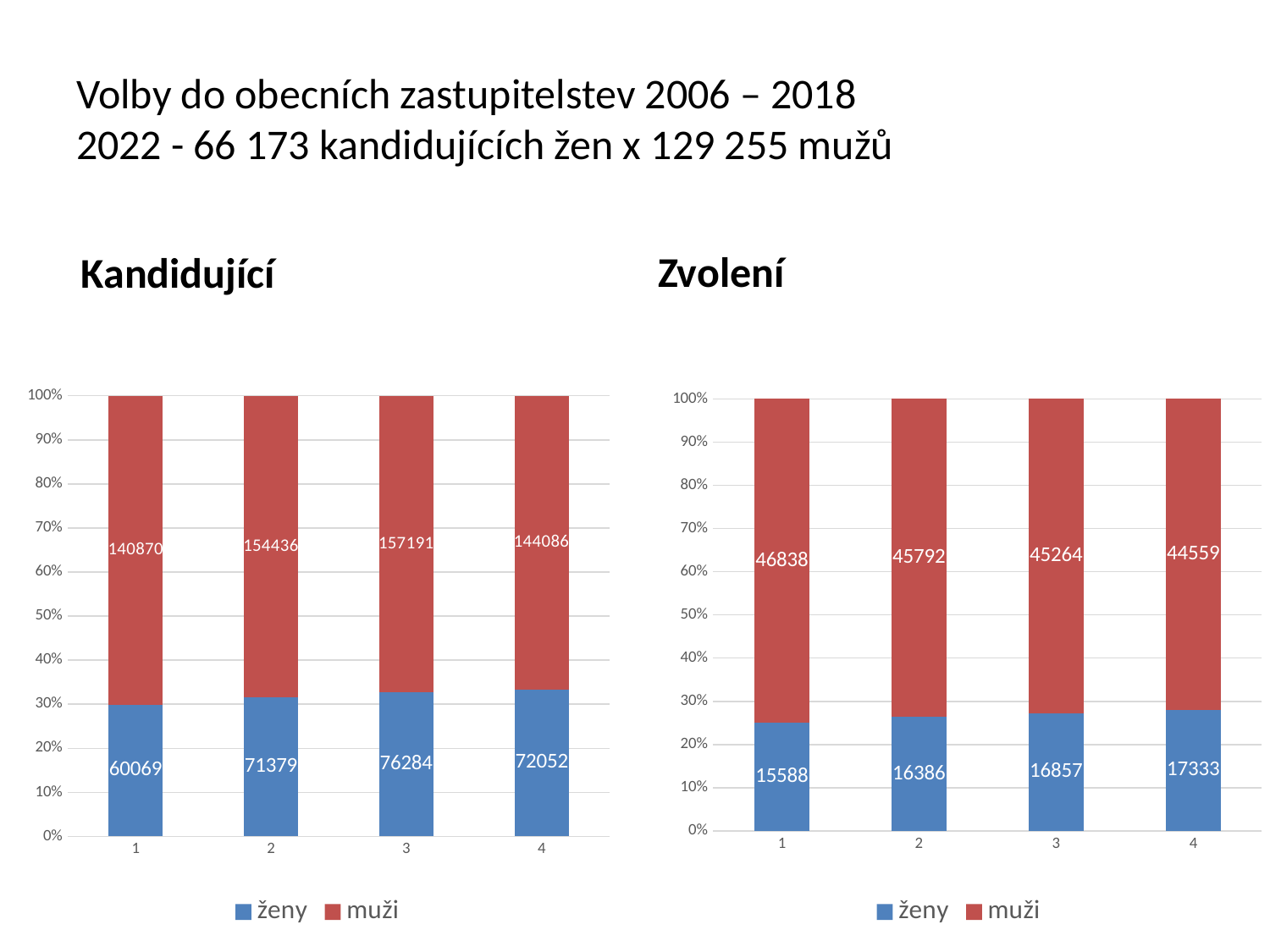
In the Zvolení chart, which category has the lowest value for muži? 4 In the Kandidující chart, which category has the highest value for ženy? 3 In the Zvolení chart, what is the difference between the ženy values for category 4 and category 1? 1745 In the Kandidující chart, what is the value for muži in category 3? 157191 How many categories are shown on the x axis of the Kandidující chart? 4 In the Kandidující chart, what is the difference between the muži values for category 3 and category 1? 16321 In the Kandidující chart, which is larger: the ženy value for category 2 or for category 4? category 4 In the Zvolení chart, is the ženy share of the bar for category 1 greater or less than 30%? less In the Zvolení chart, what is the value for ženy in category 2? 16386 What kind of chart is the Zvolení chart? stacked bar chart In the Zvolení chart, do the ženy values rise or fall from category 1 to category 4? rise How many series does the legend of the Zvolení chart list? 2